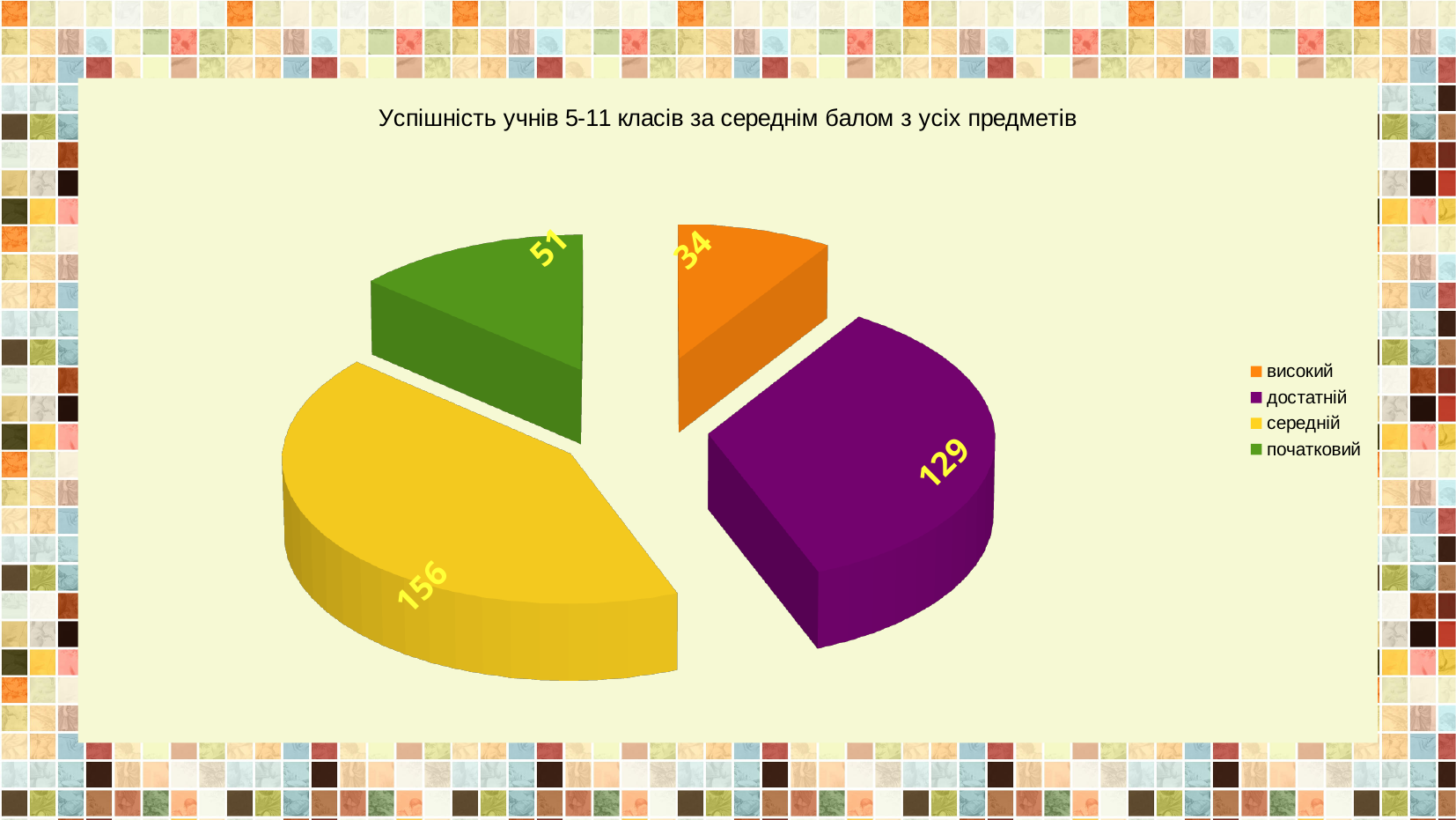
Which category has the smallest slice? високий What is the value for the "середній" slice? 156 Which category has the largest slice? середній What kind of chart is shown on the slide? Pie chart How many categories does the legend list? 4 What colour is the "достатній" slice? Purple What is the difference between the "середній" and "достатній" values? 27 What is the difference between the "початковий" and "високий" values? 17 What is the value for the "високий" slice? 34 What is the value for the "достатній" slice? 129 Which is larger, the value for "достатній" or the value for "початковий"? достатній What is the value for the "початковий" slice? 51